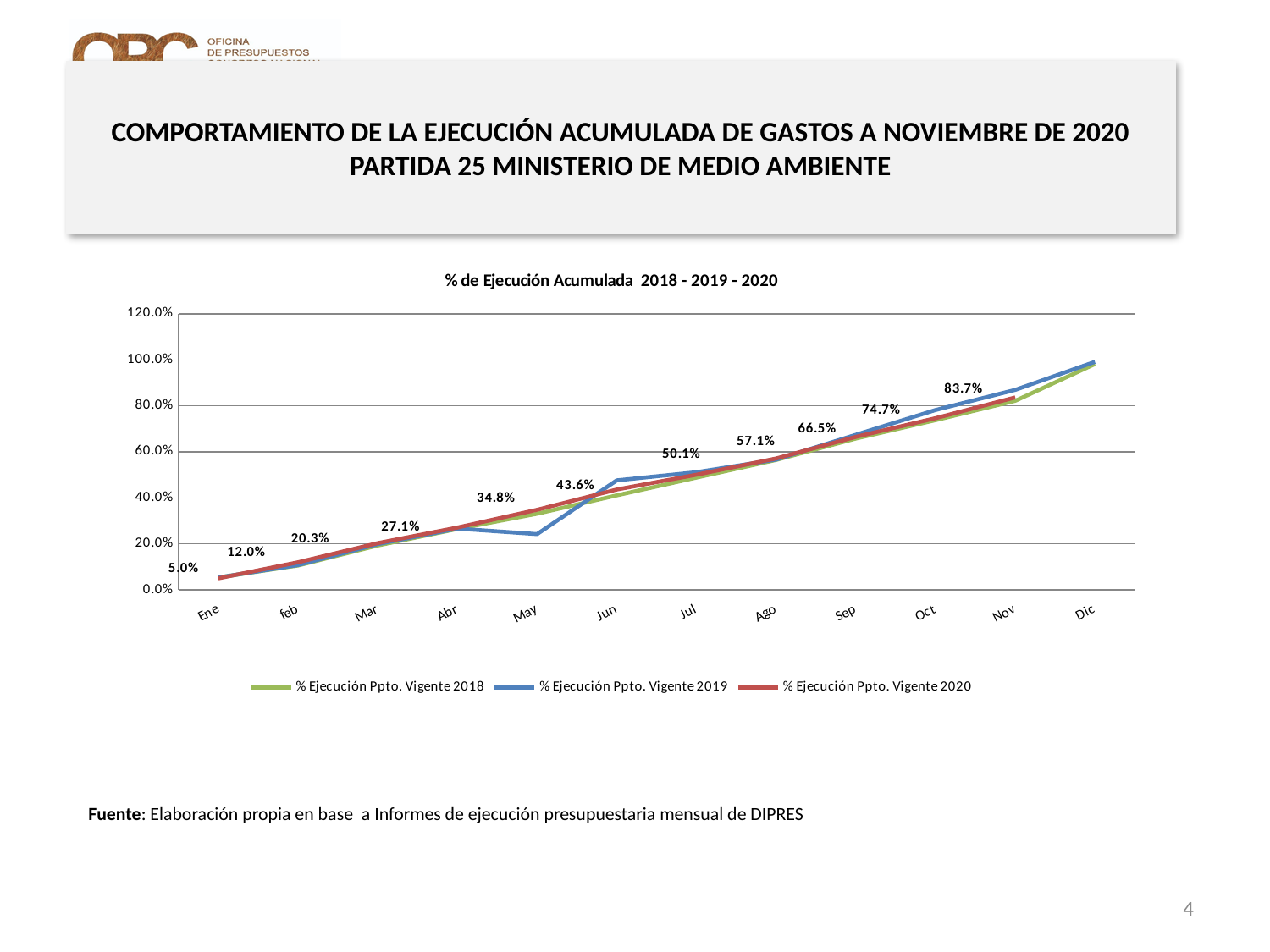
What is the value of % Ejecución Ppto. Vigente 2020 for Ene? 5.0% How many series does the legend list? 3 What is the title of the chart? % de Ejecución Acumulada 2018 - 2019 - 2020 How many months are shown on the x axis? 12 What is the value of % Ejecución Ppto. Vigente 2020 for Nov? 83.7% What type of chart is shown on the slide? line chart Is the value of % Ejecución Ppto. Vigente 2019 for Dic greater or less than 80.0%? greater Does the % Ejecución Ppto. Vigente 2020 series rise or fall from Ene to Nov? rise What is the value of % Ejecución Ppto. Vigente 2020 for Jun? 43.6% What is the difference between the % Ejecución Ppto. Vigente 2020 values for Nov and Oct? 9.0% Which is larger for May: % Ejecución Ppto. Vigente 2020 or % Ejecución Ppto. Vigente 2019? % Ejecución Ppto. Vigente 2020 What is the value of % Ejecución Ppto. Vigente 2020 for Sep? 66.5%